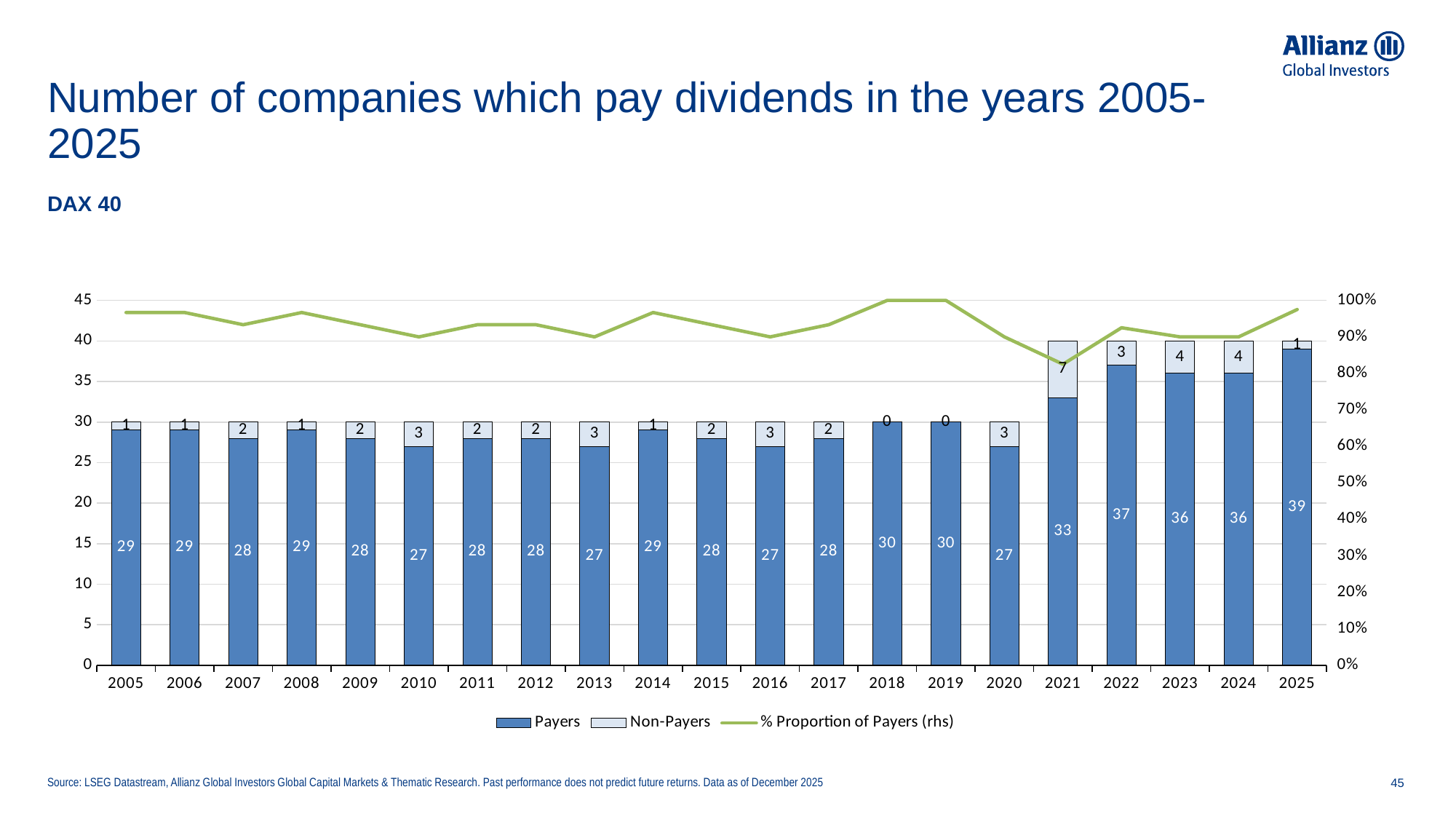
How many series does the legend list? 3 Which year has the highest number of Non-Payers? 2021 What is the difference between the number of Payers in 2022 and in 2021? 4 What kind of chart is used to show Payers and Non-Payers? Stacked bar chart What is the total height of the stacked bar for 2023 (Payers plus Non-Payers)? 40 Which year has the highest number of Payers? 2025 What is the number of Non-Payers in 2021? 7 What is the total height of the stacked bar for 2010 (Payers plus Non-Payers)? 30 Is the % Proportion of Payers in 2021 greater or less than 90%? less What is the number of Payers in 2025? 39 How many years are shown on the x axis? 21 Which is larger, the number of Payers in 2018 or in 2020? 2018